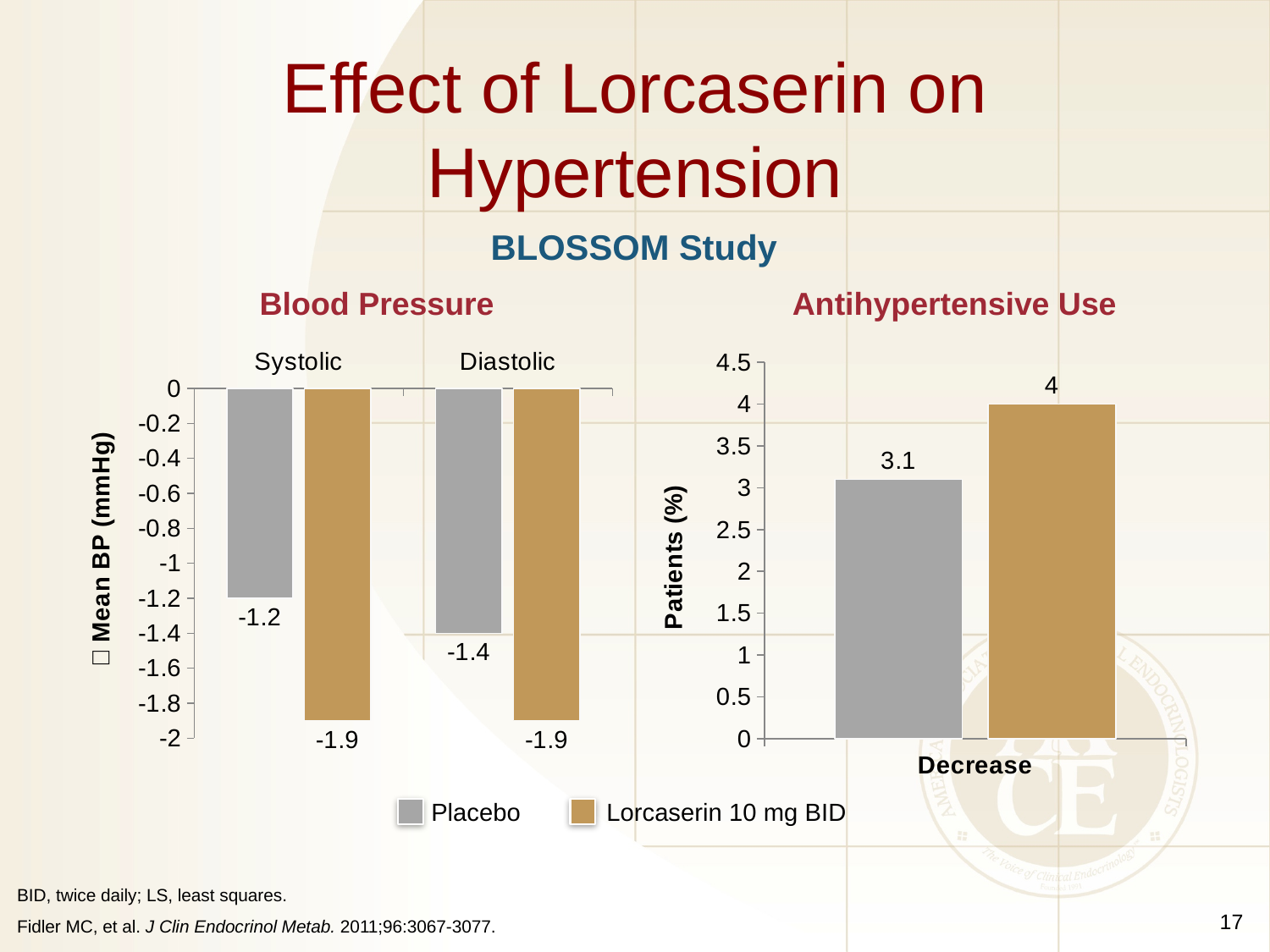
In the Blood Pressure chart, what is the Placebo value for Systolic? -1.2 In the Blood Pressure chart, what is the Lorcaserin 10 mg BID value for Diastolic? -1.9 What kind of chart is the Antihypertensive Use chart? Bar chart How many categories are shown on the x axis of the Blood Pressure chart? 2 In the Antihypertensive Use chart, what is the Lorcaserin 10 mg BID value for Decrease? 4 In the Antihypertensive Use chart, what is the Placebo value for Decrease? 3.1 In the Antihypertensive Use chart, which series has the higher value, Placebo or Lorcaserin 10 mg BID? Lorcaserin 10 mg BID In the Blood Pressure chart, which series shows the larger decrease for Systolic, Placebo or Lorcaserin 10 mg BID? Lorcaserin 10 mg BID In the Blood Pressure chart, what is the difference between the Placebo values for Systolic and Diastolic? 0.2 How many series does the legend list? 2 In the Antihypertensive Use chart, what is the difference between the Lorcaserin 10 mg BID and Placebo values? 0.9 In the Blood Pressure chart, what is the Placebo value for Diastolic? -1.4